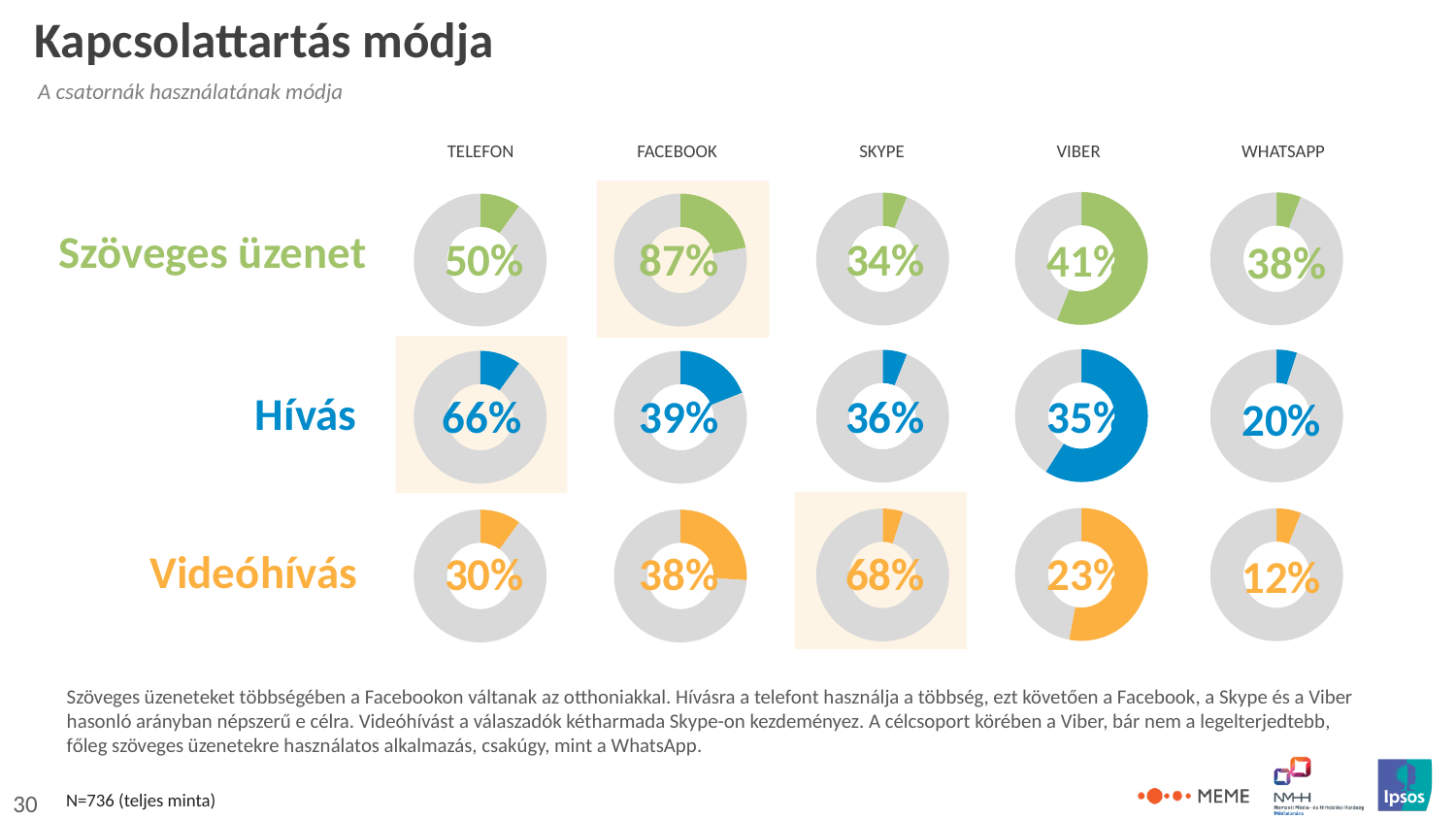
What percentage is shown for Hívás on Telefon? 66% In the Szöveges üzenet row, which channel has the highest percentage? Facebook In the Videóhívás row, which channel has the highest percentage? Skype What is the title of the slide? Kapcsolattartás módja In the Hívás row, which channel has the lowest percentage? WhatsApp What kind of chart is used to show each percentage on the slide? Donut chart What percentage is shown for Szöveges üzenet on Facebook? 87% Which is larger: the Hívás percentage on Telefon or on Facebook? Telefon What is the difference between the Szöveges üzenet percentage on Facebook and on Telefon? 37% What percentage is shown for Videóhívás on WhatsApp? 12% What percentage is shown for Videóhívás on Skype? 68% How many channels (columns) are shown in the grid of charts? 5